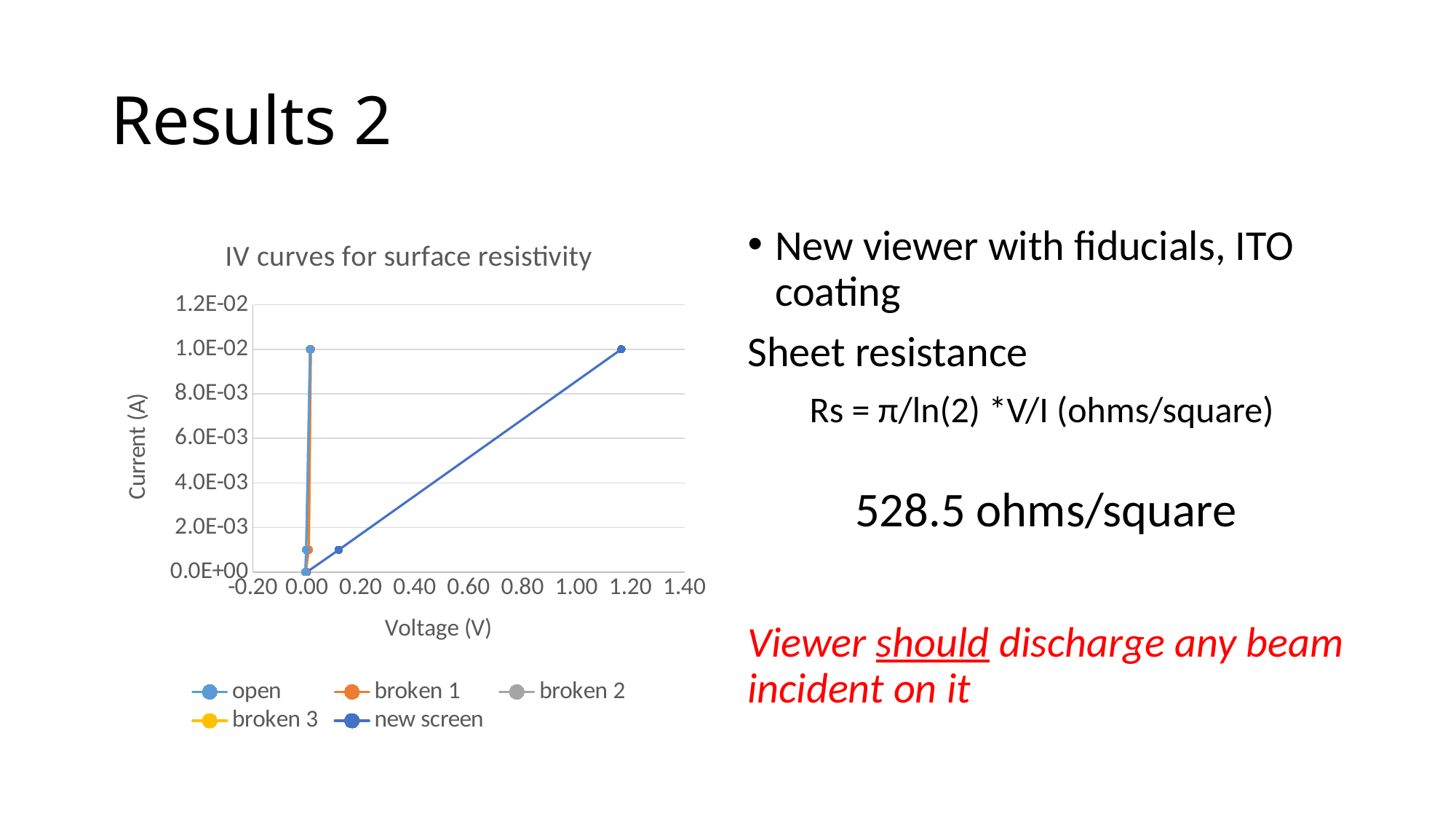
What kind of chart is shown on the slide? line chart What label is on the x axis of the chart? Voltage (V) Which series extends to the highest voltage on the chart? new screen Does the current of the new screen series rise or fall as voltage increases? rise Is the voltage of the highest point of the open series greater or less than 0.20? less Is the voltage of the highest point of the new screen series greater or less than 1.00? greater At the highest current plotted, which series has the larger voltage, new screen or open? new screen How many series does the chart legend list? 5 Is the maximum current reached by the new screen series greater or less than 1.2E-02? less What is the title of the chart? IV curves for surface resistivity